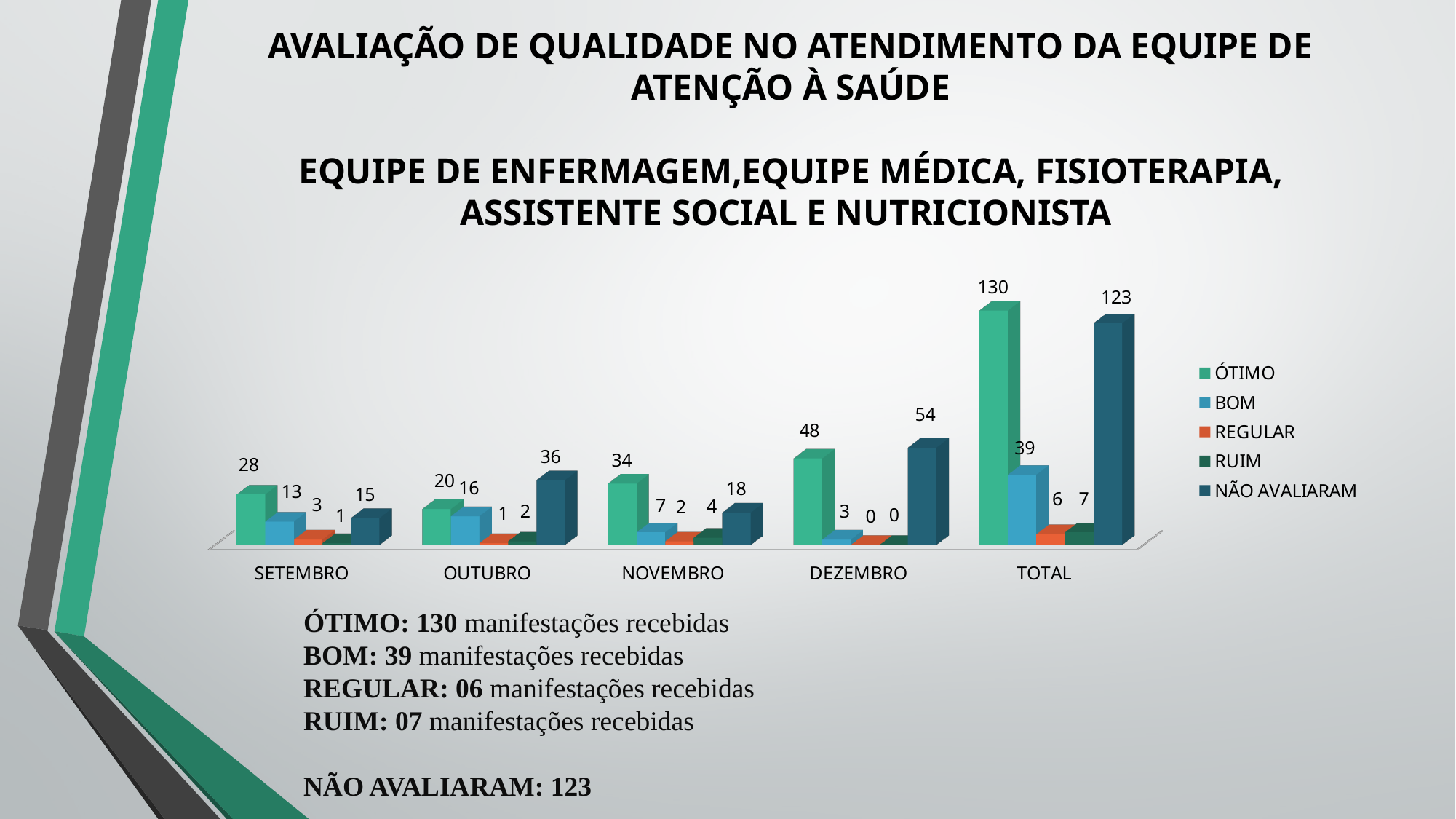
What is the value for BOM in NOVEMBRO? 7 How many series does the legend list? 5 What is the value for ÓTIMO in SETEMBRO? 28 What is the difference between the ÓTIMO and NÃO AVALIARAM values in the TOTAL category? 7 Which series is shown in orange in the legend? REGULAR What kind of chart is shown on the slide? bar chart What is the value for ÓTIMO in DEZEMBRO? 48 What is the value for NÃO AVALIARAM in OUTUBRO? 36 Which month has the highest ÓTIMO value (excluding TOTAL)? DEZEMBRO Which month has the lowest BOM value (excluding TOTAL)? DEZEMBRO In DEZEMBRO, which is larger: ÓTIMO or NÃO AVALIARAM? NÃO AVALIARAM How many categories are shown on the x axis? 5